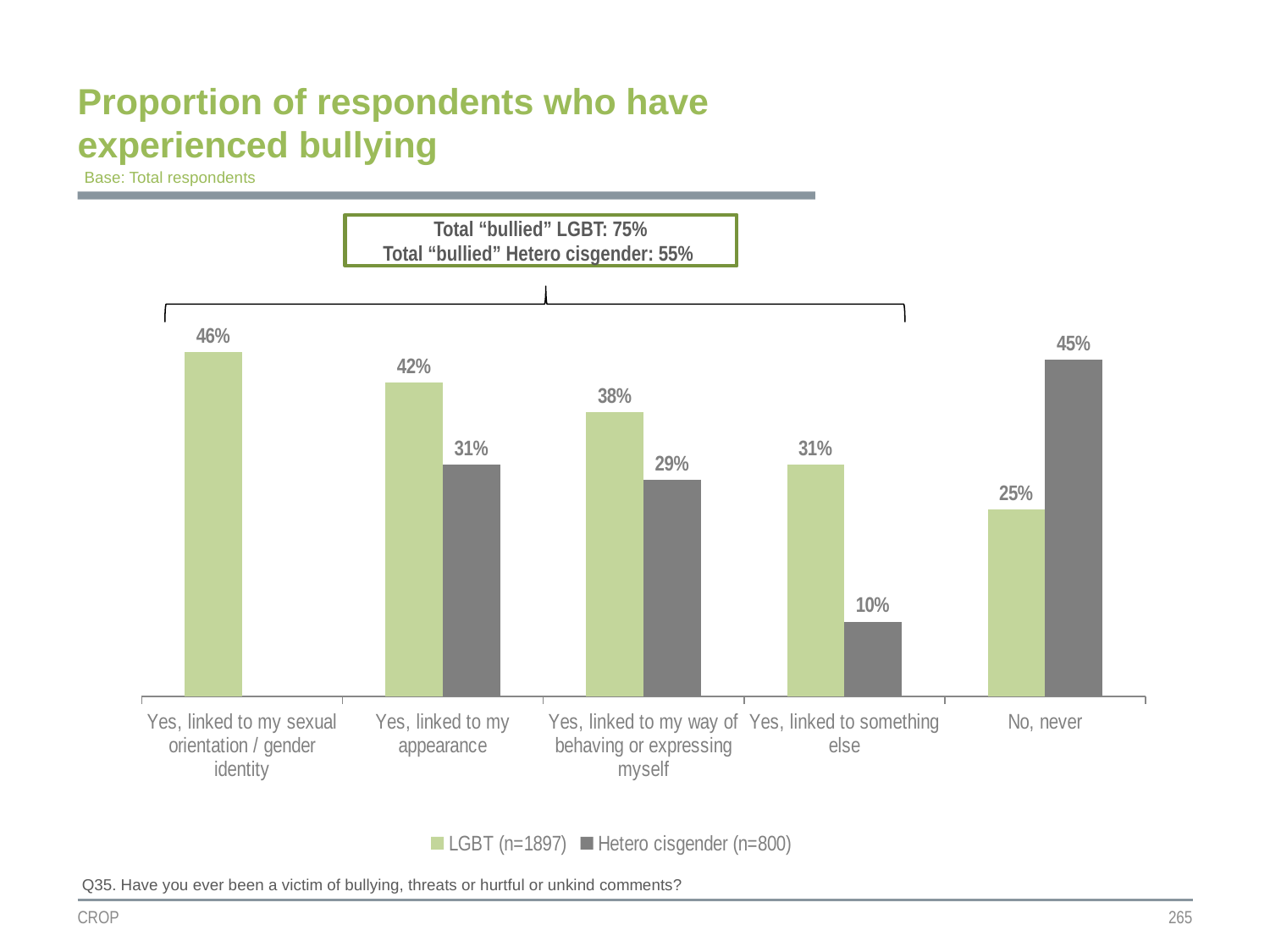
Which category has the lowest value for Hetero cisgender respondents? Yes, linked to something else What percentage of Hetero cisgender respondents reported bullying linked to their appearance? 31% What percentage of LGBT respondents reported bullying linked to their sexual orientation / gender identity? 46% What is the sample size for the Hetero cisgender series according to the legend? n=800 How many series does the legend list? 2 What is the difference between LGBT and Hetero cisgender respondents for 'Yes, linked to something else'? 21 percentage points What is the total 'bullied' proportion for LGBT respondents shown in the box above the chart? 75% What percentage of Hetero cisgender respondents answered 'No, never'? 45% What kind of chart is shown on the slide? Bar chart Which category has the highest value for LGBT respondents? Yes, linked to my sexual orientation / gender identity For 'No, never', which group has the larger value, LGBT or Hetero cisgender? Hetero cisgender How many categories are shown on the x axis? 5